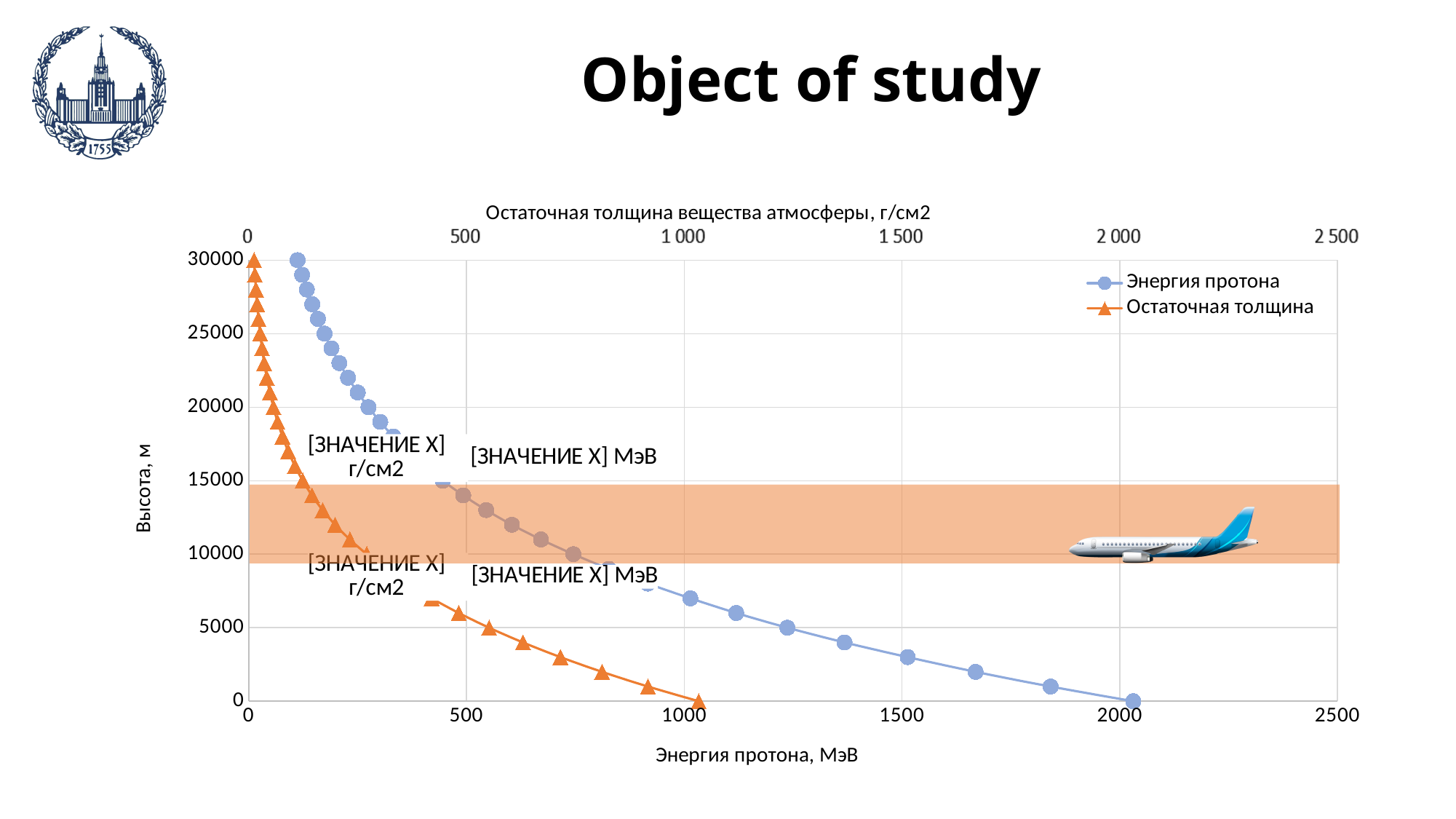
Is the proton energy (Энергия протона) at a height of 0 m greater or less than 2000 МэВ? greater What kind of chart is shown on the slide? Scatter (line) chart with markers As height decreases from 30000 m to 0 m, does the proton energy (Энергия протона) rise or fall? rise How many series does the legend list? 2 At a height of 0 m, which series has the larger x value: Энергия протона or Остаточная толщина? Энергия протона What are the two series named in the legend? Энергия протона and Остаточная толщина Is the residual thickness (Остаточная толщина) at a height of 0 m greater or less than 1000 г/см2? greater What is the maximum value shown on the vertical (height) axis? 30000 What is the title of the vertical axis? Высота, м Is the proton energy (Энергия протона) at a height of 5000 m greater or less than 1000 МэВ? greater